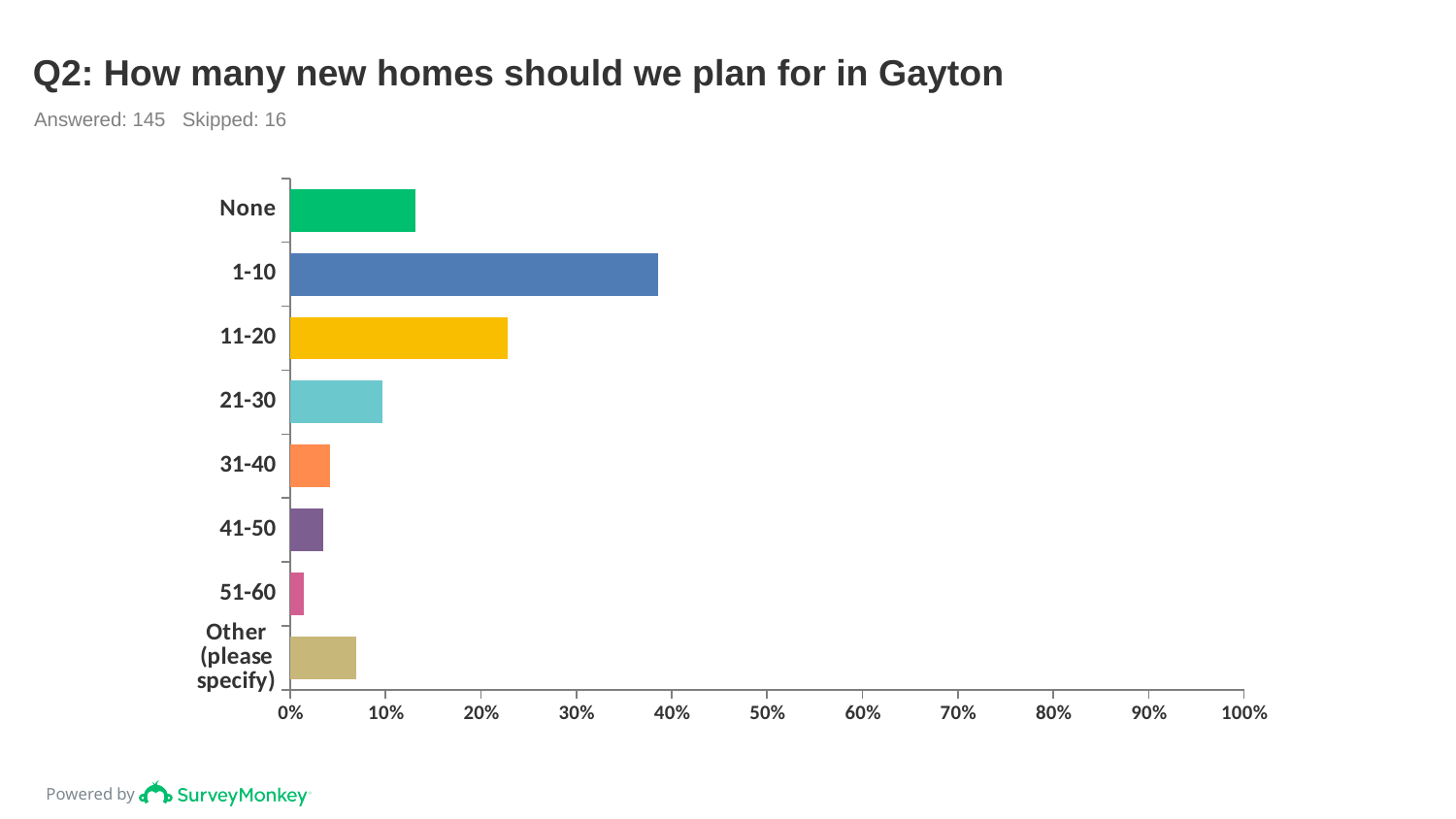
Which category has the highest value? 1-10 What kind of chart is shown on the slide? bar chart Is the value for 1-10 greater or less than 30%? greater Which is larger, the value for 21-30 or the value for Other (please specify)? 21-30 Is the value for None greater or less than 10%? greater What is the title of the chart? Q2: How many new homes should we plan for in Gayton Which is larger, the value for None or the value for 11-20? 11-20 Is the value for 11-20 greater or less than 30%? less How many categories are shown on the chart? 8 Which category has the lowest value? 51-60 How many respondents answered this question according to the slide? 145